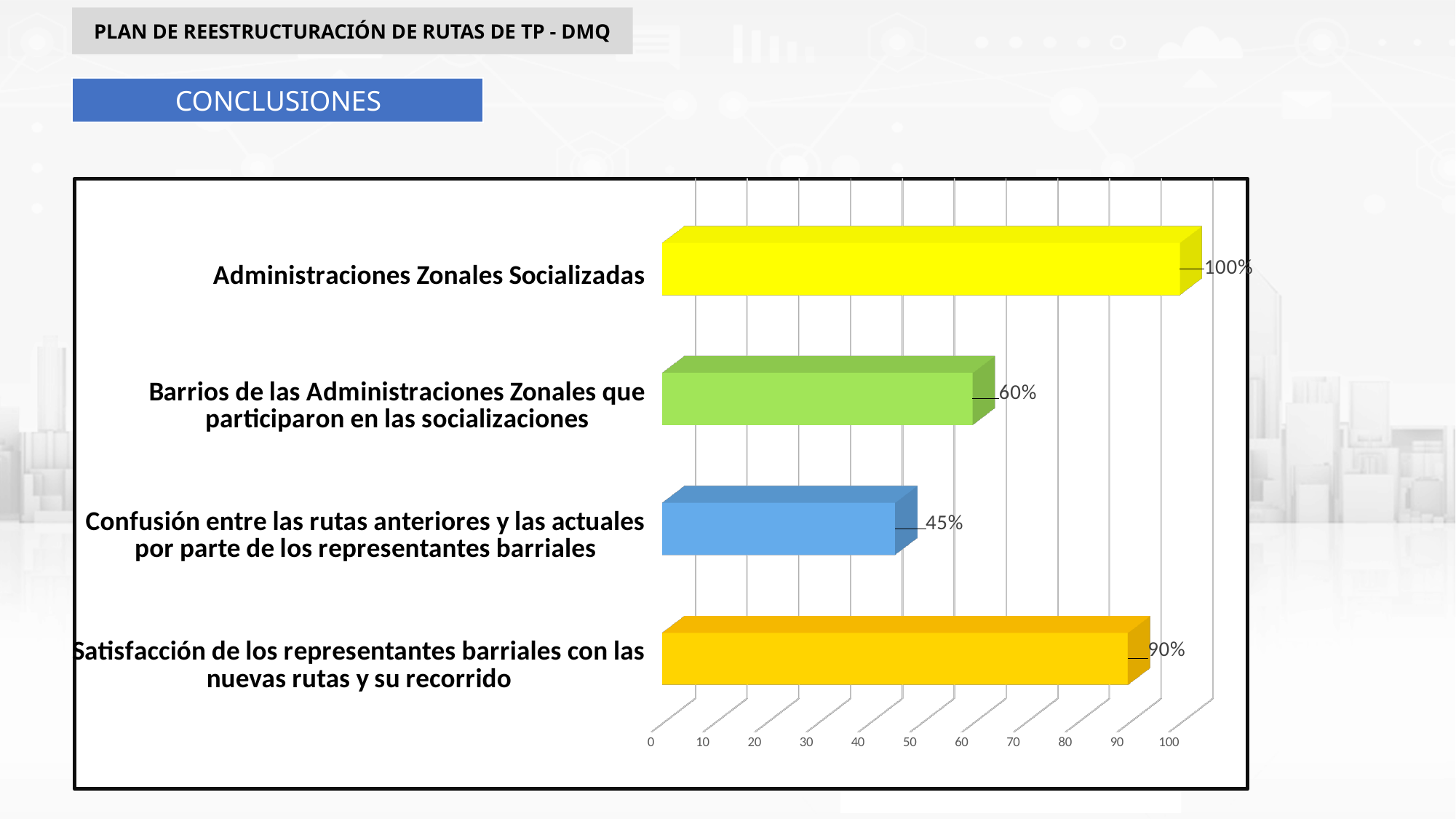
What kind of chart is shown on the slide? Bar chart What is the difference between the value for Barrios de las Administraciones Zonales que participaron en las socializaciones and the value for Confusión entre las rutas anteriores y las actuales por parte de los representantes barriales? 15% Which category has the highest value? Administraciones Zonales Socializadas How many categories are shown in the chart? 4 Which is larger: the value for Satisfacción de los representantes barriales con las nuevas rutas y su recorrido or the value for Barrios de las Administraciones Zonales que participaron en las socializaciones? Satisfacción de los representantes barriales con las nuevas rutas y su recorrido What is the value for Administraciones Zonales Socializadas? 100% Which category has the lowest value? Confusión entre las rutas anteriores y las actuales por parte de los representantes barriales What is the value for Barrios de las Administraciones Zonales que participaron en las socializaciones? 60% What is the value for Confusión entre las rutas anteriores y las actuales por parte de los representantes barriales? 45% What is the difference between the value for Administraciones Zonales Socializadas and the value for Satisfacción de los representantes barriales con las nuevas rutas y su recorrido? 10% What is the value for Satisfacción de los representantes barriales con las nuevas rutas y su recorrido? 90% What colour is the bar for Confusión entre las rutas anteriores y las actuales por parte de los representantes barriales? Blue